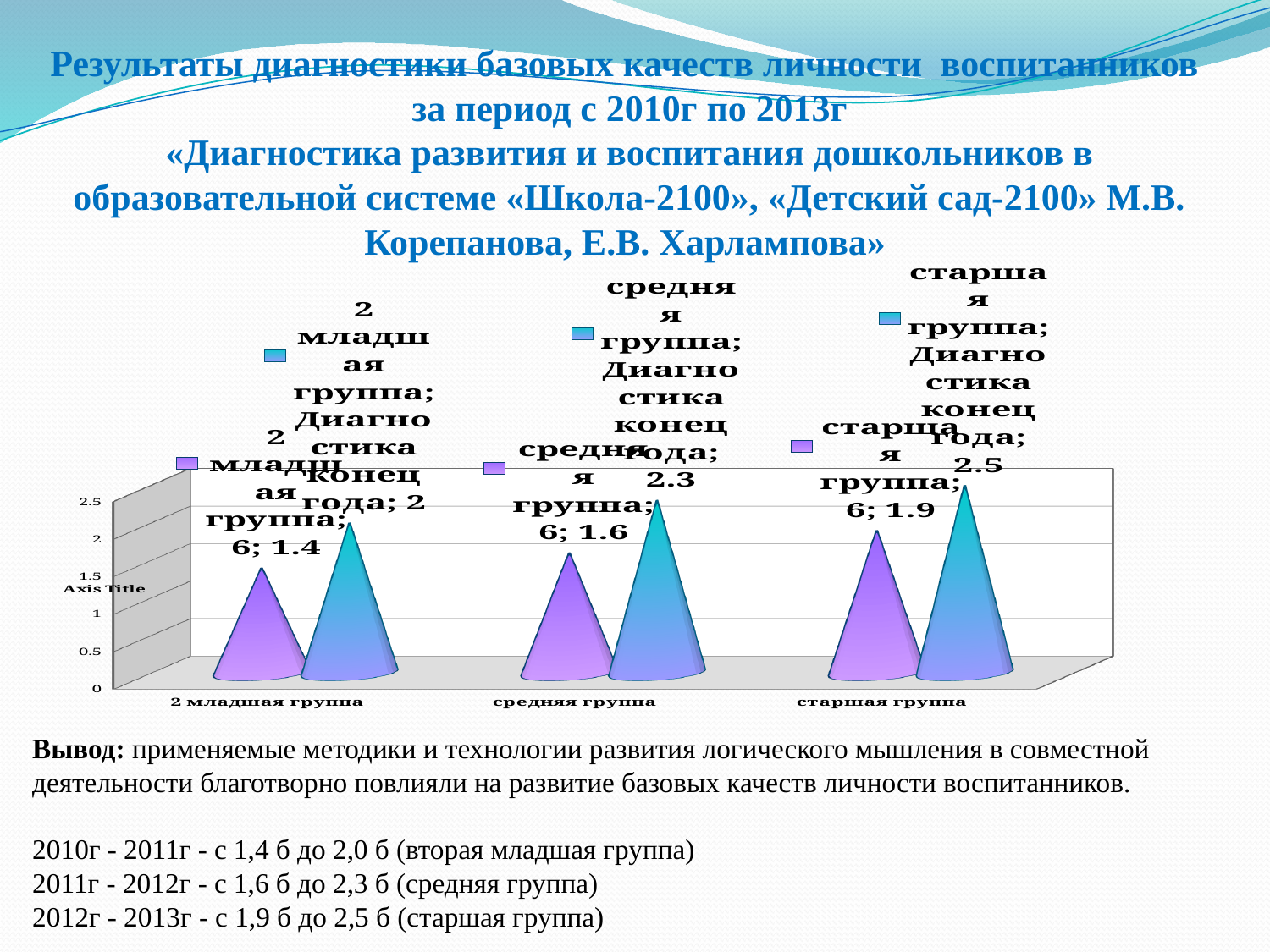
What is the purple (first series) value for 'средняя группа'? 1.6 What type of chart is shown on the slide? bar chart (3D cone bars) What is the maximum value shown on the vertical axis of the chart? 2.5 Which group has the lowest purple (first series) value? 2 младшая группа Which is larger for 'старшая группа': the purple value or the teal value? the teal value (2.5) What is the 'Диагностика конец года' (teal) value for 'старшая группа'? 2.5 What is the purple (first series) value for '2 младшая группа'? 1.4 How many groups (categories) are shown on the x axis of the chart? 3 Which group has the highest 'Диагностика конец года' (teal) value? старшая группа What is the 'Диагностика конец года' (teal) value for '2 младшая группа'? 2 What is the difference between the teal and purple values for 'средняя группа'? 0.7 Do the 'Диагностика конец года' (teal) values rise or fall from '2 младшая группа' to 'старшая группа'? rise